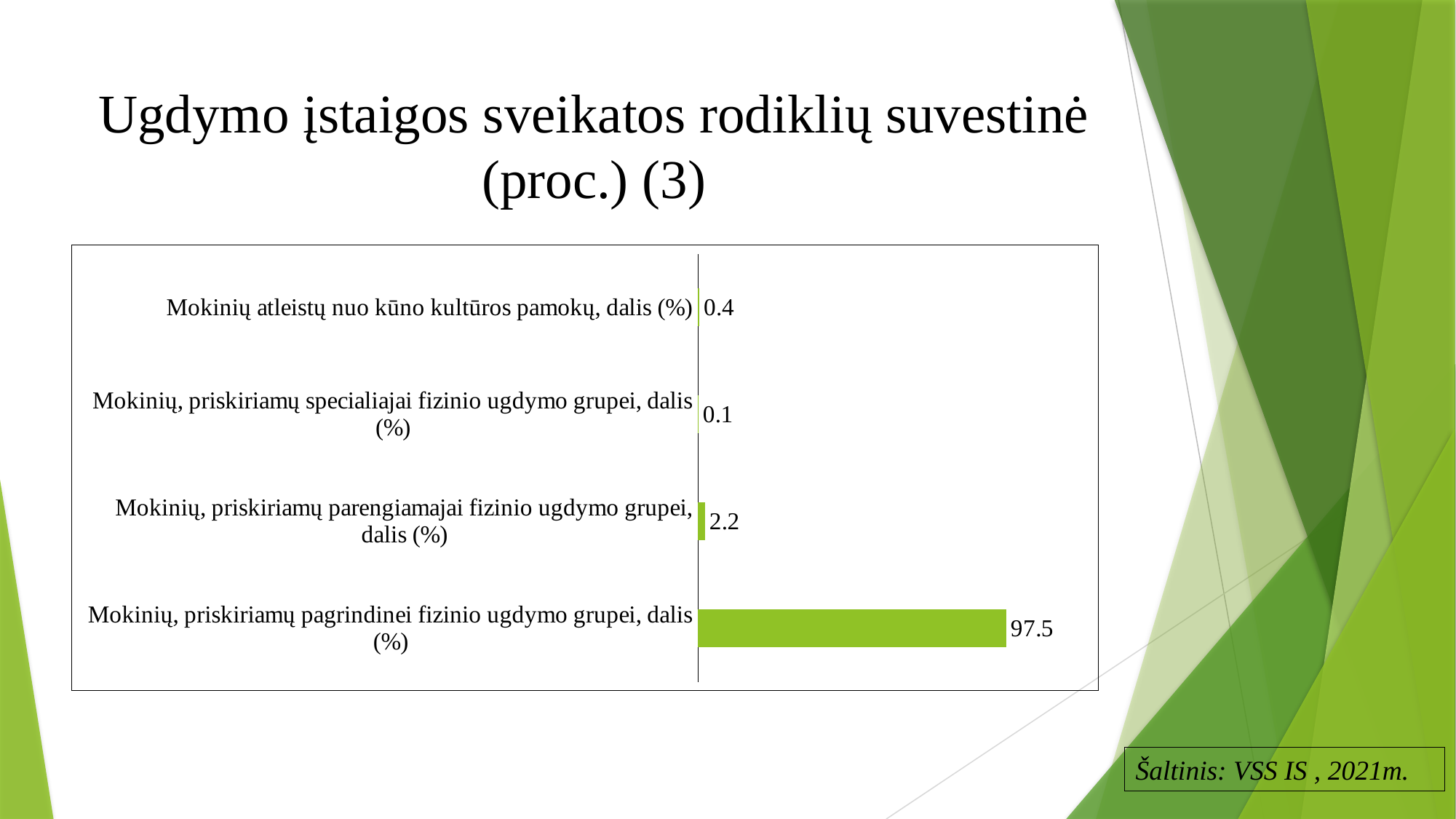
Which category has the highest value? Mokinių, priskiriamų pagrindinei fizinio ugdymo grupei, dalis (%) What is the title of the slide containing the chart? Ugdymo įstaigos sveikatos rodiklių suvestinė (proc.) (3) What is the value for 'Mokinių atleistų nuo kūno kultūros pamokų, dalis (%)'? 0.4 What is the difference between the values for 'Mokinių atleistų nuo kūno kultūros pamokų, dalis (%)' and 'Mokinių, priskiriamų specialiajai fizinio ugdymo grupei, dalis (%)'? 0.3 How many categories are shown in the chart? 4 What is the difference between the values for 'Mokinių, priskiriamų pagrindinei fizinio ugdymo grupei, dalis (%)' and 'Mokinių, priskiriamų parengiamajai fizinio ugdymo grupei, dalis (%)'? 95.3 Which category has the lowest value? Mokinių, priskiriamų specialiajai fizinio ugdymo grupei, dalis (%) What is the value for 'Mokinių, priskiriamų specialiajai fizinio ugdymo grupei, dalis (%)'? 0.1 Which is larger: the value for 'Mokinių atleistų nuo kūno kultūros pamokų, dalis (%)' or the value for 'Mokinių, priskiriamų parengiamajai fizinio ugdymo grupei, dalis (%)'? Mokinių, priskiriamų parengiamajai fizinio ugdymo grupei, dalis (%) What is the value for 'Mokinių, priskiriamų parengiamajai fizinio ugdymo grupei, dalis (%)'? 2.2 What is the value for 'Mokinių, priskiriamų pagrindinei fizinio ugdymo grupei, dalis (%)'? 97.5 What kind of chart is shown on the slide? Bar chart